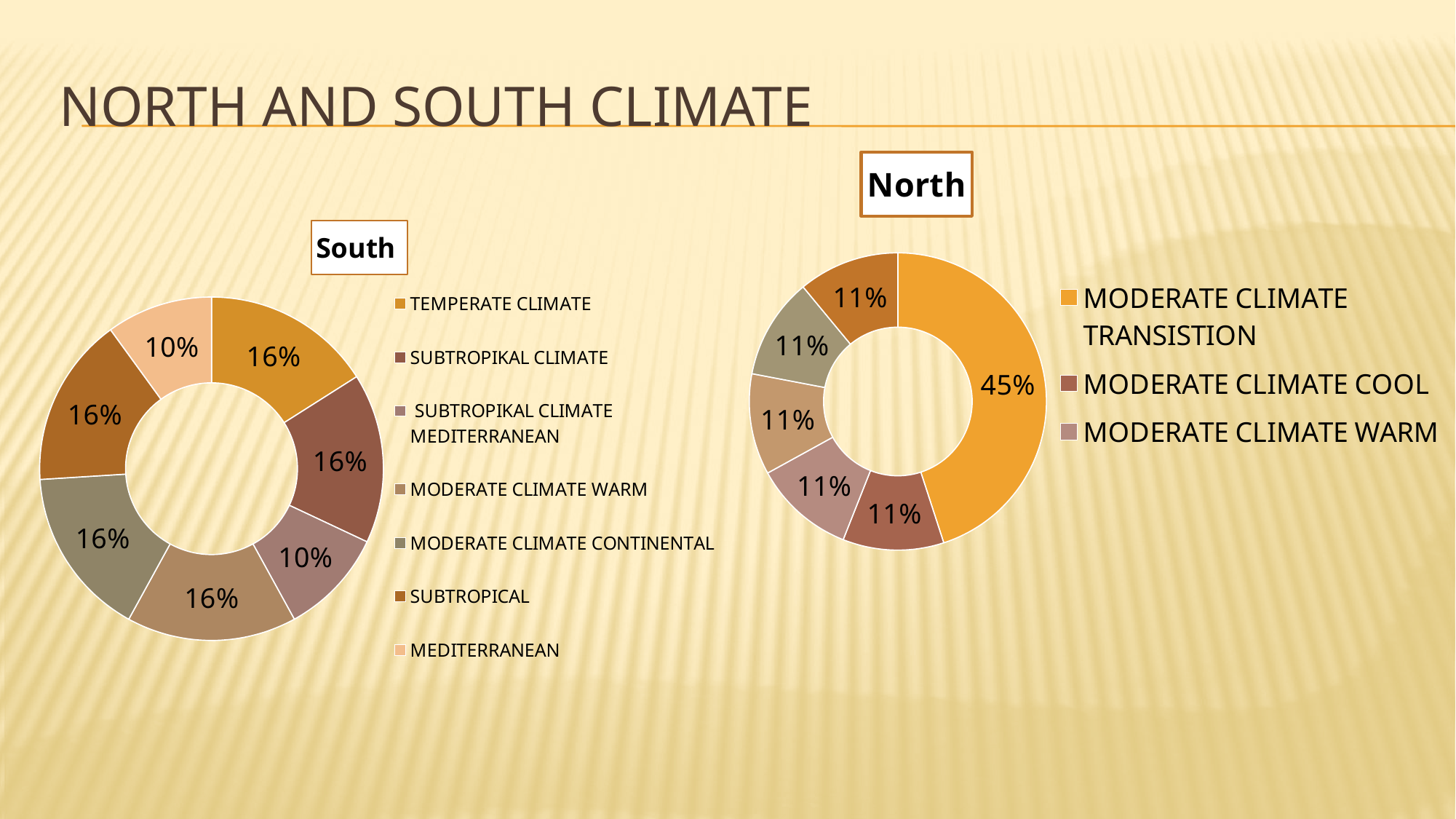
On the North chart, which category has the largest slice? MODERATE CLIMATE TRANSISTION On the South chart, what percentage is shown for MODERATE CLIMATE WARM? 16% On the South chart, what is the difference between TEMPERATE CLIMATE and MEDITERRANEAN? 6 percentage points On the North chart, how many slices does the doughnut have? 6 On the North chart, what is the difference between MODERATE CLIMATE TRANSISTION and MODERATE CLIMATE WARM? 34 percentage points On the North chart, what percentage is shown for MODERATE CLIMATE COOL? 11% On the South chart, what percentage is shown for MEDITERRANEAN? 10% On the South chart, what percentage is shown for TEMPERATE CLIMATE? 16% On the South chart, how many slices does the doughnut have? 7 On the South chart, which is larger, TEMPERATE CLIMATE or MEDITERRANEAN? TEMPERATE CLIMATE What kind of chart is the South chart? Doughnut chart On the North chart, what percentage is shown for MODERATE CLIMATE TRANSISTION? 45%